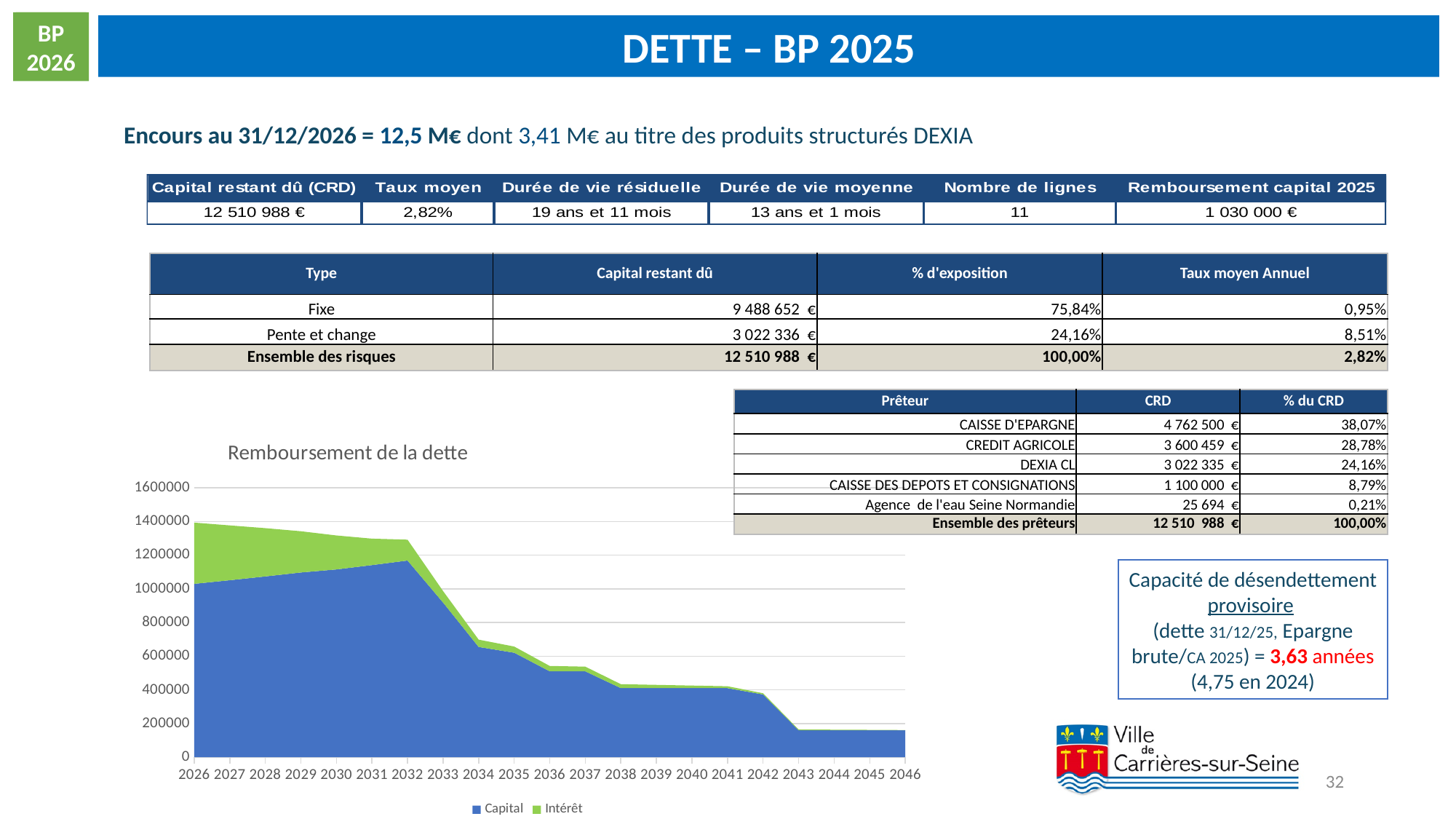
In the "Remboursement de la dette" chart, is the Capital value for 2043 greater or less than 200000? less Which two series are shown in the legend of the "Remboursement de la dette" chart? Capital and Intérêt How many years are shown on the x axis of the "Remboursement de la dette" chart? 21 In the "Remboursement de la dette" chart, is the Capital value for 2036 greater or less than 600000? less What kind of chart is "Remboursement de la dette"? Area chart In the "Remboursement de la dette" chart, which year has the highest total repayment (Capital plus Intérêt)? 2026 In the "Remboursement de la dette" chart, is the total repayment for 2026 greater or less than 1200000? greater How many series does the legend of the "Remboursement de la dette" chart list? 2 In the "Remboursement de la dette" chart, which colour represents the Intérêt series? Green In the "Remboursement de la dette" chart, which is larger in 2026: Capital or Intérêt? Capital In the "Remboursement de la dette" chart, do the total repayments rise or fall from 2032 to 2046? Fall